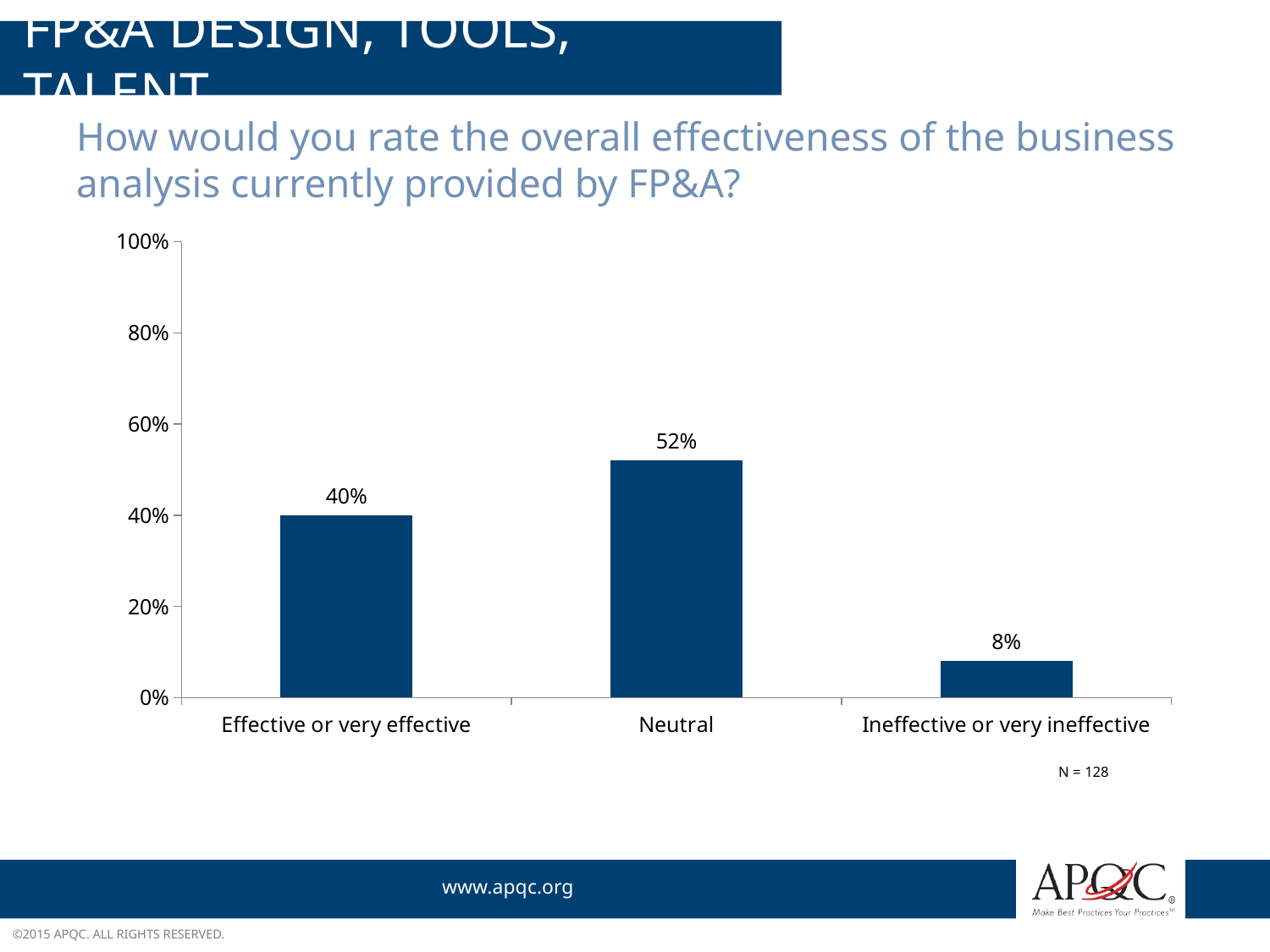
Which category has a larger share: Effective or very effective, or Neutral? Neutral What is the difference in percentage points between the Effective or very effective and the Ineffective or very ineffective categories? 32 percentage points What percentage of respondents gave a Neutral rating? 52% Is the value for Neutral greater or less than 60%? less What percentage of respondents rated the business analysis as ineffective or very ineffective? 8% What is the difference in percentage points between the Neutral and the Effective or very effective categories? 12 percentage points How many rating categories are shown on the chart? 3 Which rating category has the lowest percentage of respondents? Ineffective or very ineffective What type of chart is used to display the ratings? Bar chart Which rating category has the highest percentage of respondents? Neutral What is the sample size (N) noted on the chart? N = 128 What percentage of respondents rated the business analysis provided by FP&A as effective or very effective? 40%